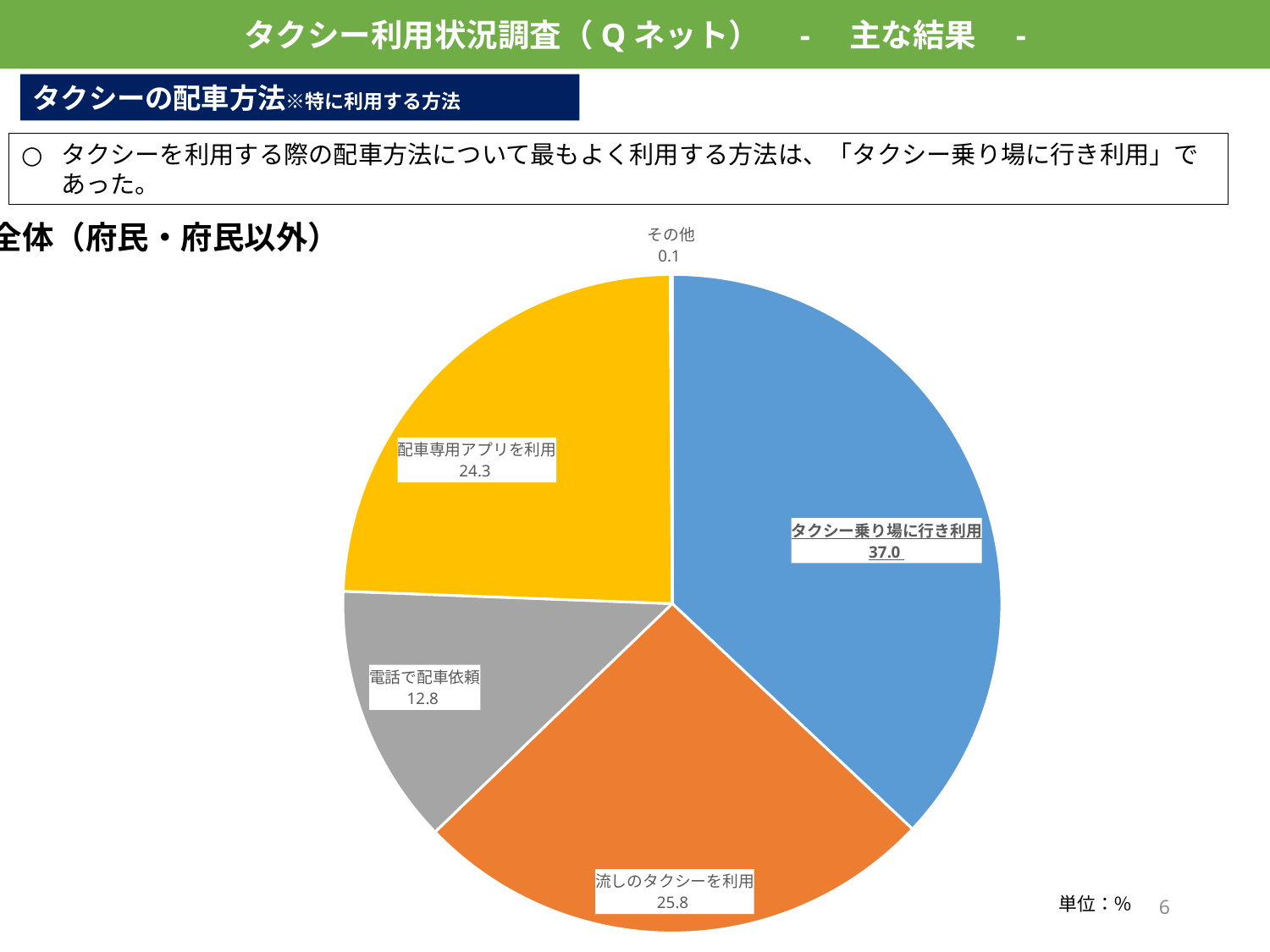
Which category has the largest slice in the pie chart? タクシー乗り場に行き利用 Which is larger, the value for タクシー乗り場に行き利用 or the value for 配車専用アプリを利用? タクシー乗り場に行き利用 What is the difference between the values for 配車専用アプリを利用 and 電話で配車依頼? 11.5 What is the value for 流しのタクシーを利用 in the pie chart? 25.8 What is the value for タクシー乗り場に行き利用 in the pie chart? 37.0 How many categories are shown in the pie chart? 5 What kind of chart is shown on the slide? pie chart Which category has the smallest slice in the pie chart? その他 What is the value for 配車専用アプリを利用 in the pie chart? 24.3 What is the value for その他 in the pie chart? 0.1 What is the value for 電話で配車依頼 in the pie chart? 12.8 What is the difference between the values for タクシー乗り場に行き利用 and 流しのタクシーを利用? 11.2